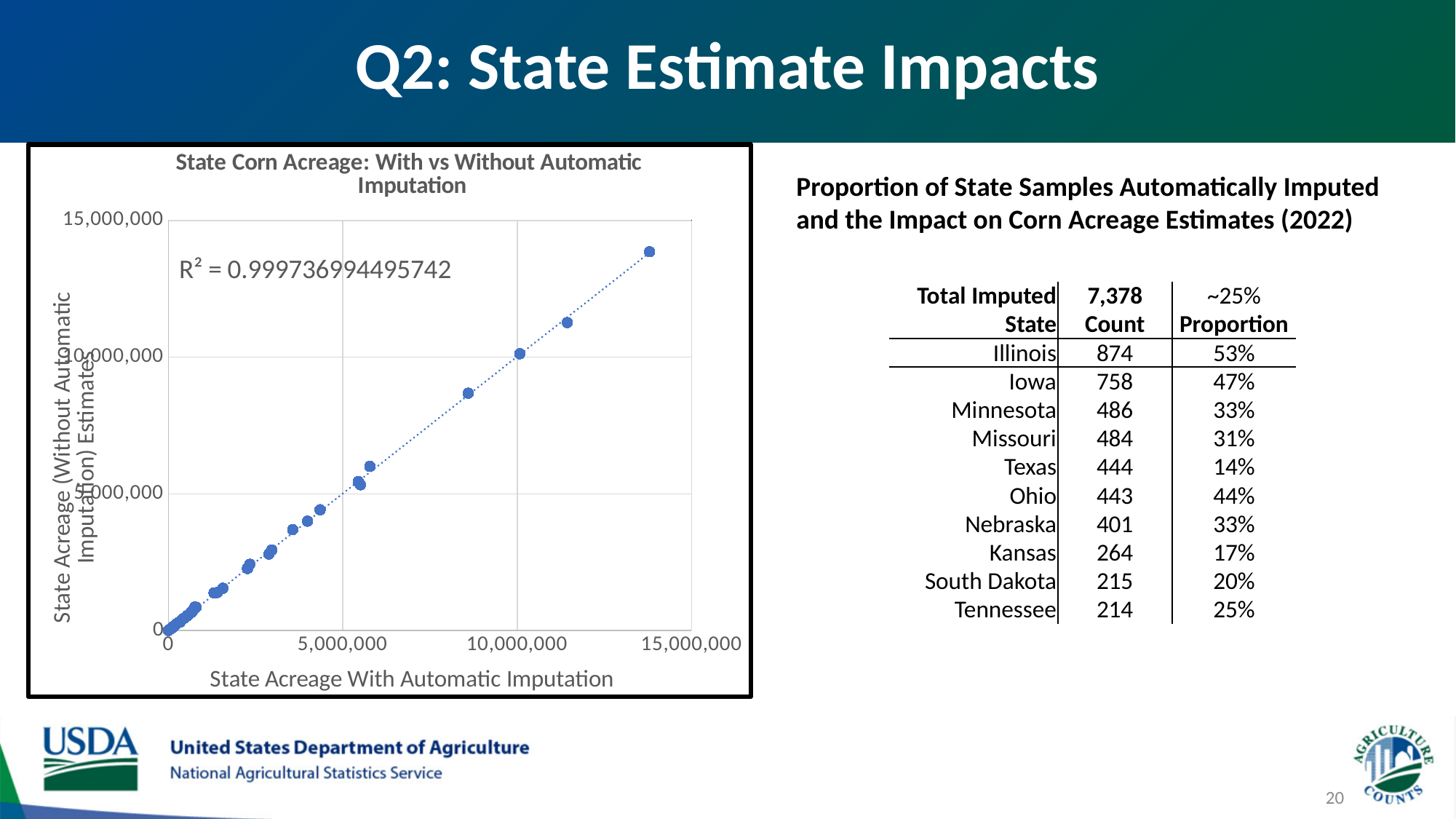
In the scatter chart, is the x value of the rightmost point greater or less than 15,000,000? less In the scatter chart, do the y values rise or fall as the x values increase? rise In the scatter chart, is the y value of the third-highest point greater or less than 15,000,000? less What is the label of the x axis of the scatter chart? State Acreage With Automatic Imputation What kind of chart is shown on the left of the slide? scatter chart What R² value is printed on the scatter chart? R² = 0.999736994495742 What is the title of the chart on the left of the slide? State Corn Acreage: With vs Without Automatic Imputation In the scatter chart, is the y value of the highest point greater or less than 10,000,000? greater